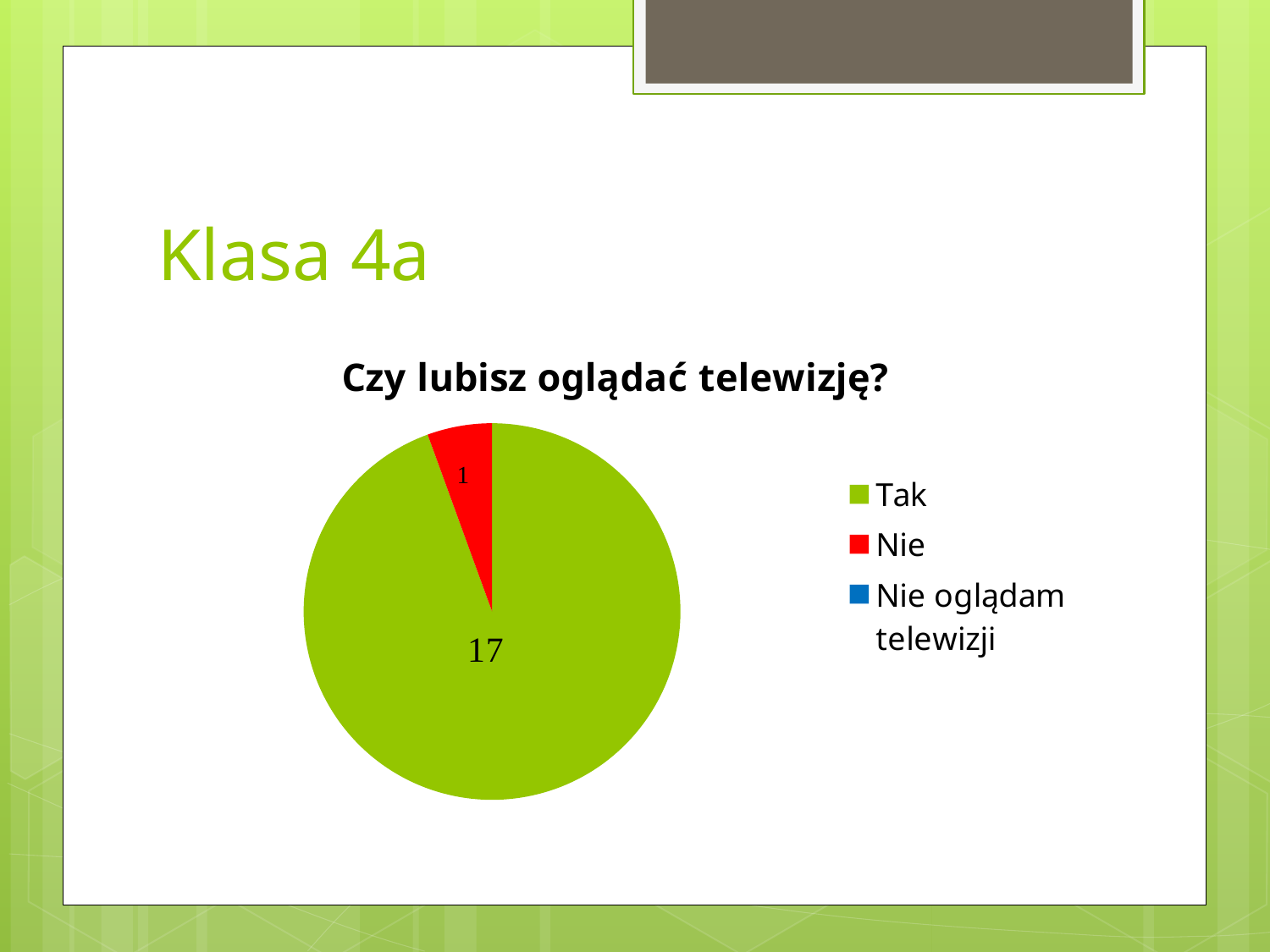
What is the difference between the number of "Tak" answers and "Nie" answers? 16 How many people answered "Nie" according to the pie chart? 1 What is the title of the pie chart? Czy lubisz oglądać telewizję? What kind of chart is shown on the slide? pie chart How many entries does the legend of the pie chart list? 3 What colour is the "Nie" slice in the pie chart? red How many slices with data labels are visible in the pie chart? 2 How many people answered "Tak" according to the pie chart? 17 Which of the two labelled slices is larger, "Tak" or "Nie"? Tak Which answer has the largest slice in the pie chart? Tak